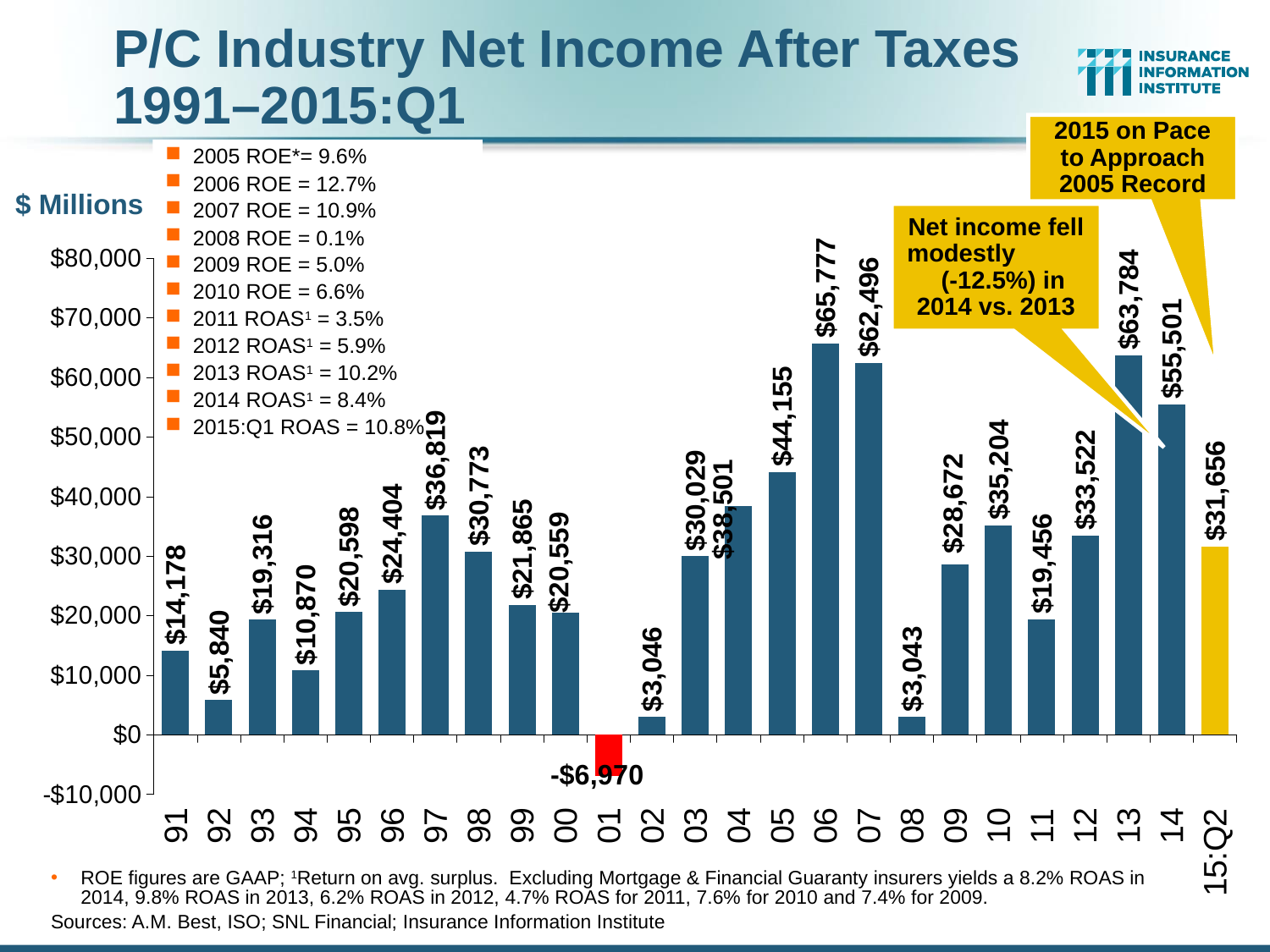
Which year has the lowest net income after taxes on the chart? 01 What is the difference between the 2006 value and the 2007 value? $3,281 Is the value for 2005 greater or less than $40,000? greater What is the value shown for the 15:Q2 bar? $31,656 What is the difference between the 2013 value and the 2014 value? $8,283 Which year has the highest net income after taxes on the chart? 06 What value is shown for the 2001 bar? -$6,970 What is the unit label shown at the top left of the chart's vertical axis? $ Millions What is the net income after taxes shown for 2006? $65,777 What kind of chart is shown on the slide? bar chart How many bars are plotted on the chart? 25 Which is larger, the value for 1997 or the value for 1998? 1997